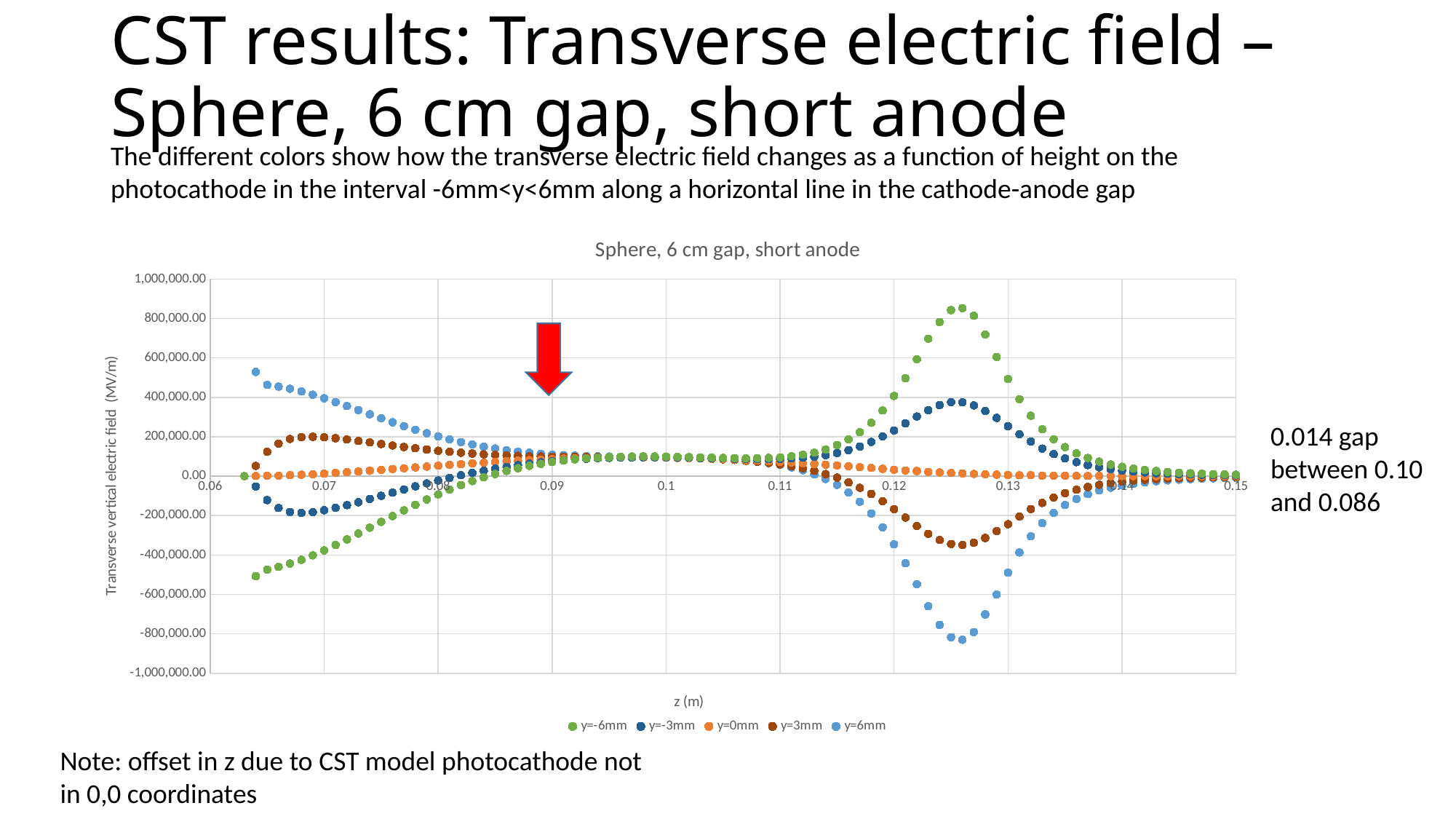
Which series reaches the highest value on the chart, near z = 0.125? y=-6mm Does the y=6mm series rise or fall as z increases from 0.06 to 0.09? fall What is the title of the chart? Sphere, 6 cm gap, short anode What is the label of the x axis of the chart? z (m) How many series does the chart legend list? 5 Is the peak value of the y=-6mm series near z = 0.125 greater or less than 600,000.00? greater Which series reaches the lowest value on the chart, near z = 0.125? y=6mm Is the minimum value of the y=6mm series near z = 0.125 greater or less than -600,000.00? less What kind of chart is shown on the slide? Scatter chart